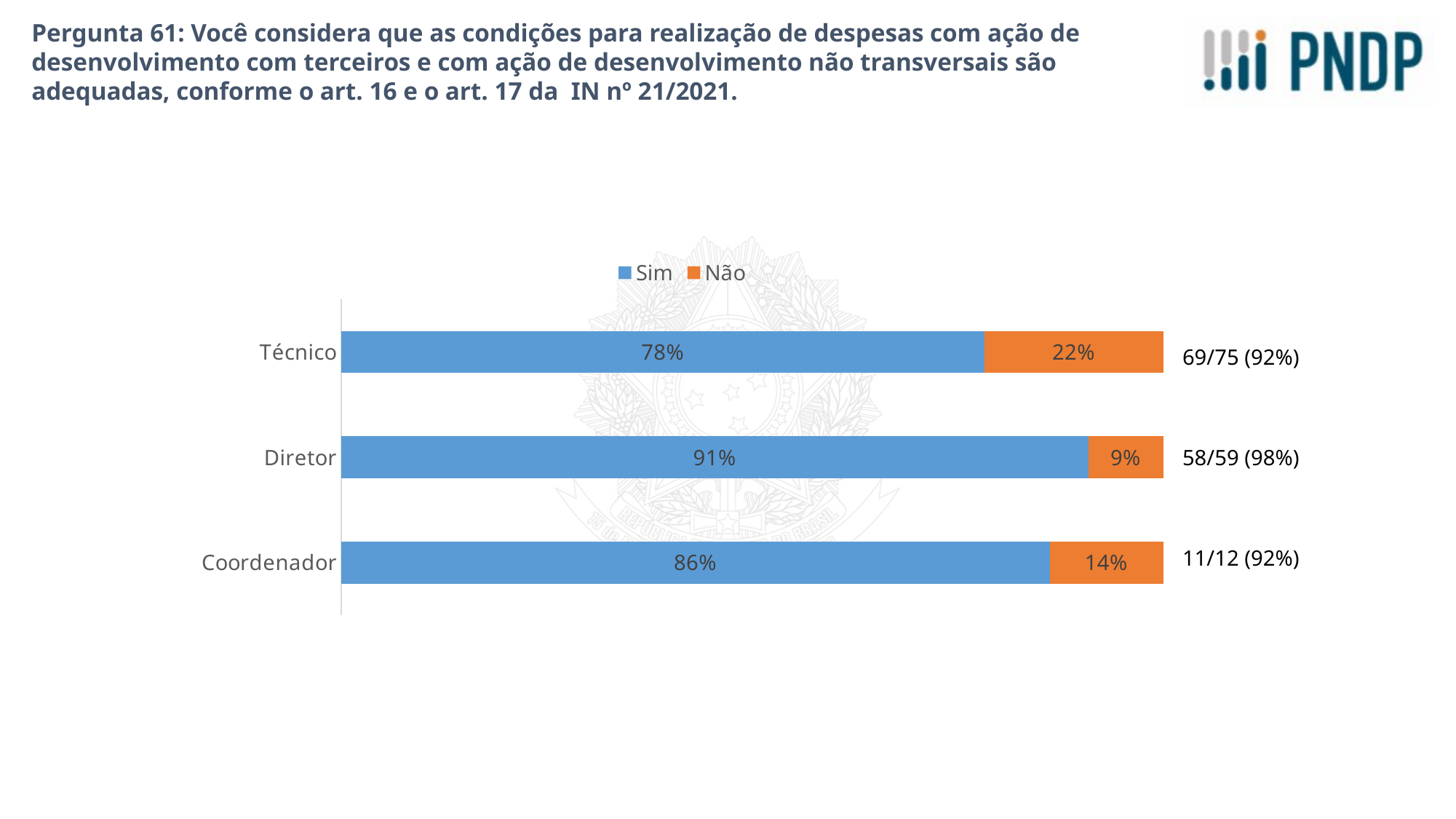
What percentage of Diretor respondents answered Não? 9% Which category has the highest Sim percentage? Diretor What colour represents the Não series in the chart? Orange What percentage of Técnico respondents answered Sim? 78% What is the total of the Sim and Não percentages for the Coordenador bar? 100% What is the difference between the Sim percentages for Diretor and Técnico? 13% How many categories are shown on the chart? 3 Which is larger, the Não percentage for Técnico or for Coordenador? Técnico What percentage of Coordenador respondents answered Sim? 86% How many series does the legend list? 2 Which category has the lowest Sim percentage? Técnico What kind of chart is shown on the slide? Stacked bar chart